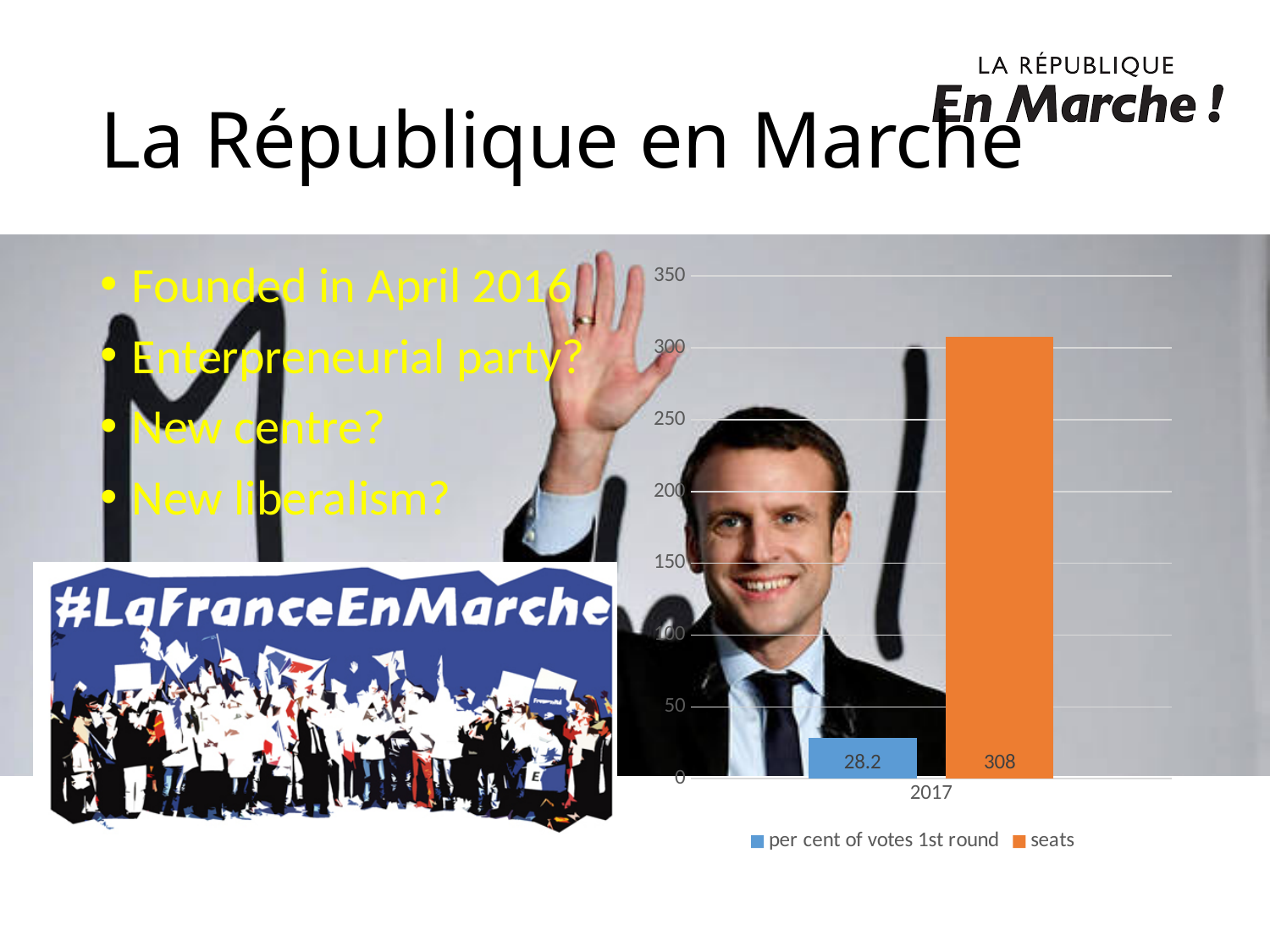
Is the value for 'seats' in 2017 greater or less than 300? greater Which series has the higher value in 2017, 'per cent of votes 1st round' or 'seats'? seats Which series is shown in orange? seats What is the difference between the 'seats' value and the 'per cent of votes 1st round' value in 2017? 279.8 How many series does the legend list? 2 What is the only category label on the x axis? 2017 What kind of chart is shown on the slide? bar chart What is the highest tick value shown on the y axis? 350 How many categories are shown on the x axis? 1 What is the value for 'seats' in 2017? 308 What is the value for 'per cent of votes 1st round' in 2017? 28.2 Is the value for 'per cent of votes 1st round' in 2017 greater or less than 50? less